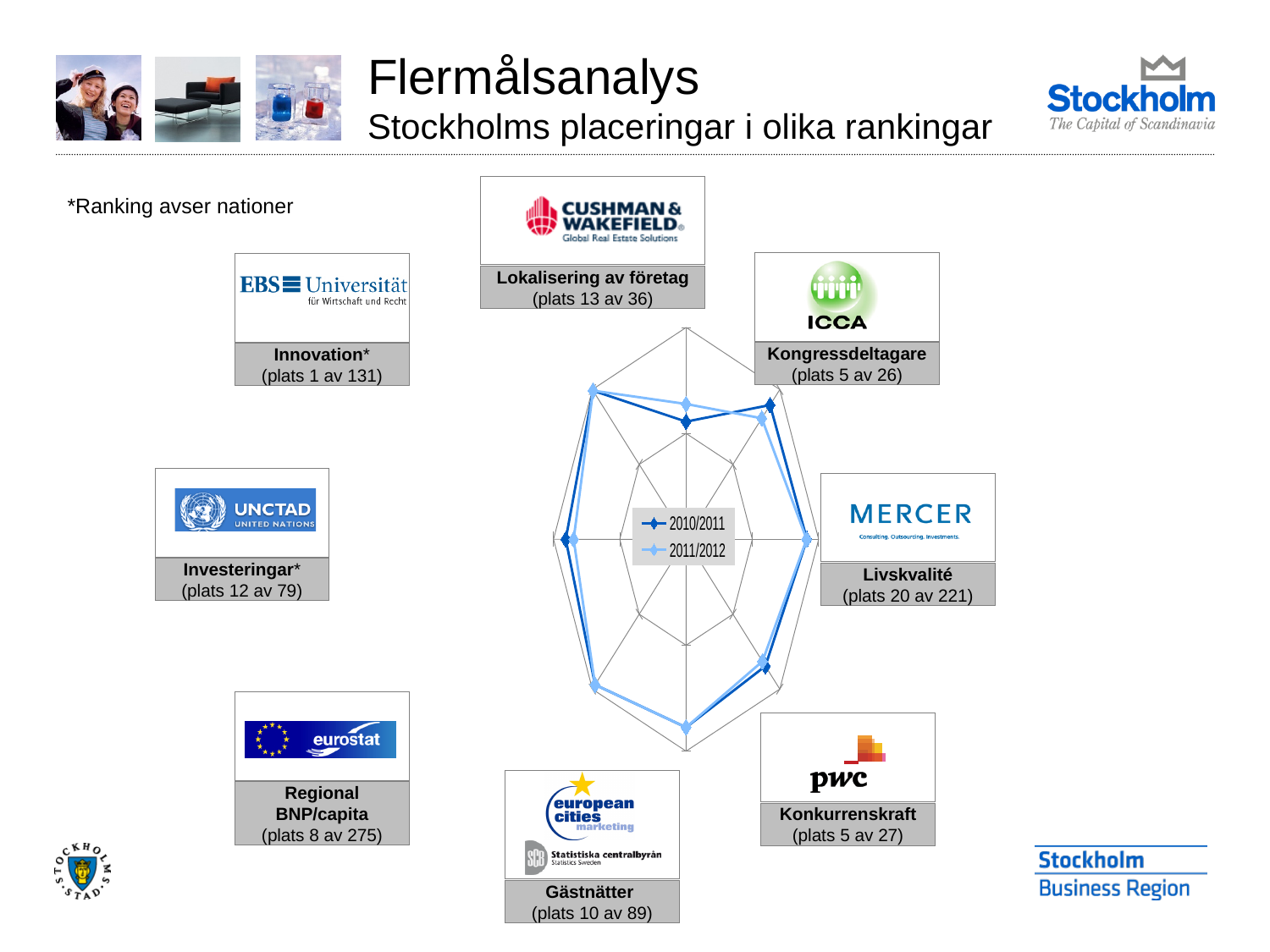
How many series does the chart's legend list? 2 According to the slide, what placement does Stockholm have in the Regional BNP/capita ranking? plats 8 av 275 How many axes (spokes) does the radar chart have? 8 According to the slide, what placement does Stockholm have in the Livskvalité ranking? plats 20 av 221 Which series is drawn in the lighter blue colour? 2011/2012 According to the slide, what placement does Stockholm have in the Gästnätter ranking? plats 10 av 89 According to the slide, what placement does Stockholm have in the Kongressdeltagare ranking? plats 5 av 26 Which two series are listed in the chart's legend? 2010/2011 and 2011/2012 According to the slide, what placement does Stockholm have in the Lokalisering av företag ranking? plats 13 av 36 What kind of chart is shown on the slide? Radar chart According to the slide, what placement does Stockholm have in the Konkurrenskraft ranking? plats 5 av 27 According to the slide, what placement does Stockholm have in the Innovation ranking? plats 1 av 131